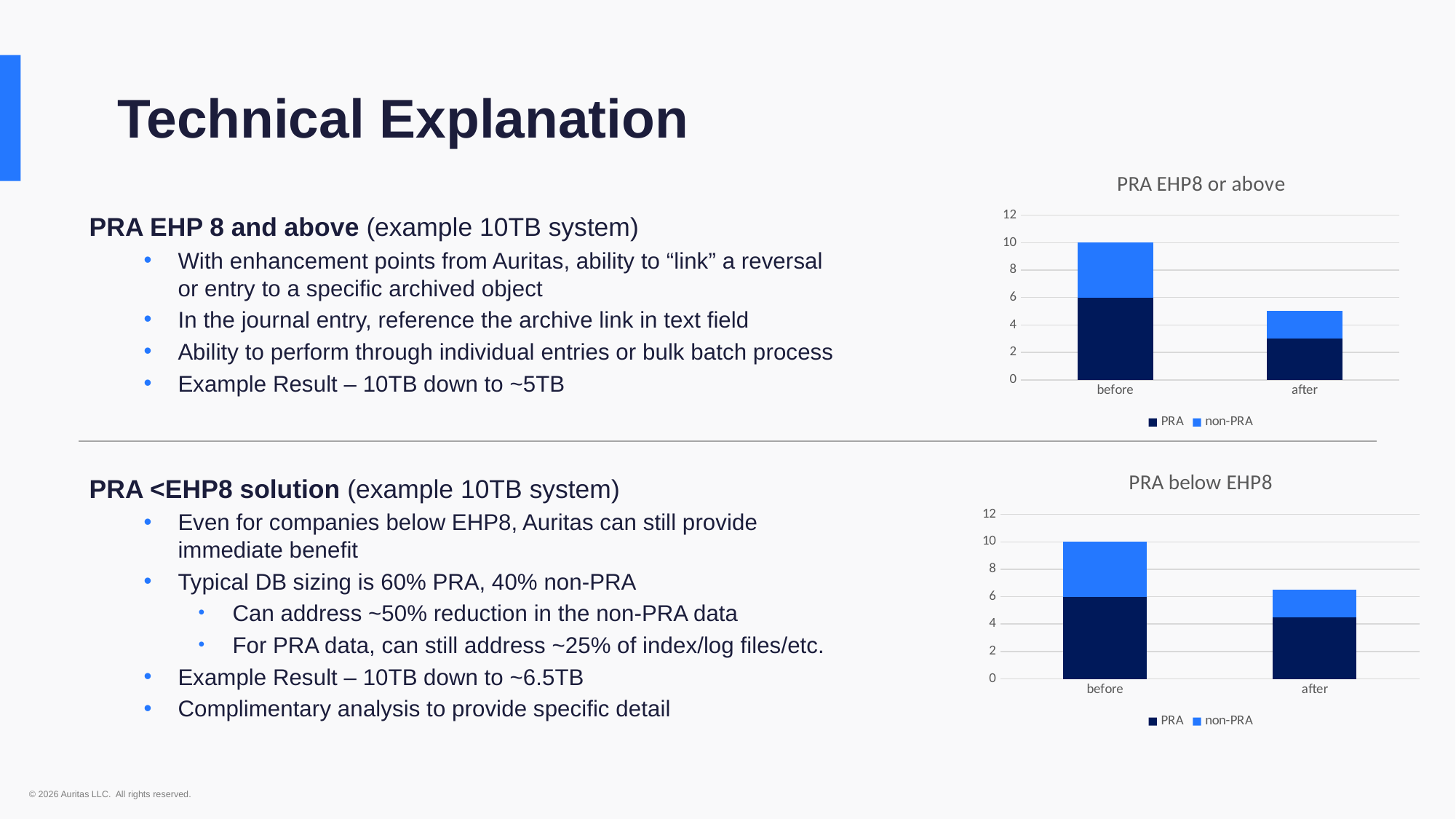
In the 'PRA below EHP8' chart, is the PRA value for 'after' greater or less than 4? greater In the 'PRA EHP8 or above' chart, is the total for 'after' greater or less than 6? less In the 'PRA EHP8 or above' chart, do the stacked bar totals rise or fall from 'before' to 'after'? fall In the 'PRA below EHP8' chart, which category has the lowest stacked bar total? after What kind of chart is the 'PRA EHP8 or above' chart? stacked bar chart In the 'PRA EHP8 or above' chart, how many categories are shown on the x axis? 2 In the 'PRA below EHP8' chart, is the total for 'after' greater or less than 6? greater In the 'PRA EHP8 or above' chart, what is the total height of the 'before' stacked bar? 10 In the 'PRA below EHP8' chart, what is the total height of the 'before' stacked bar? 10 In the 'PRA EHP8 or above' chart, what are the two series named in the legend? PRA and non-PRA In the 'PRA EHP8 or above' chart, which category has the taller stacked bar, 'before' or 'after'? before In the 'PRA EHP8 or above' chart, how many series does the legend list? 2